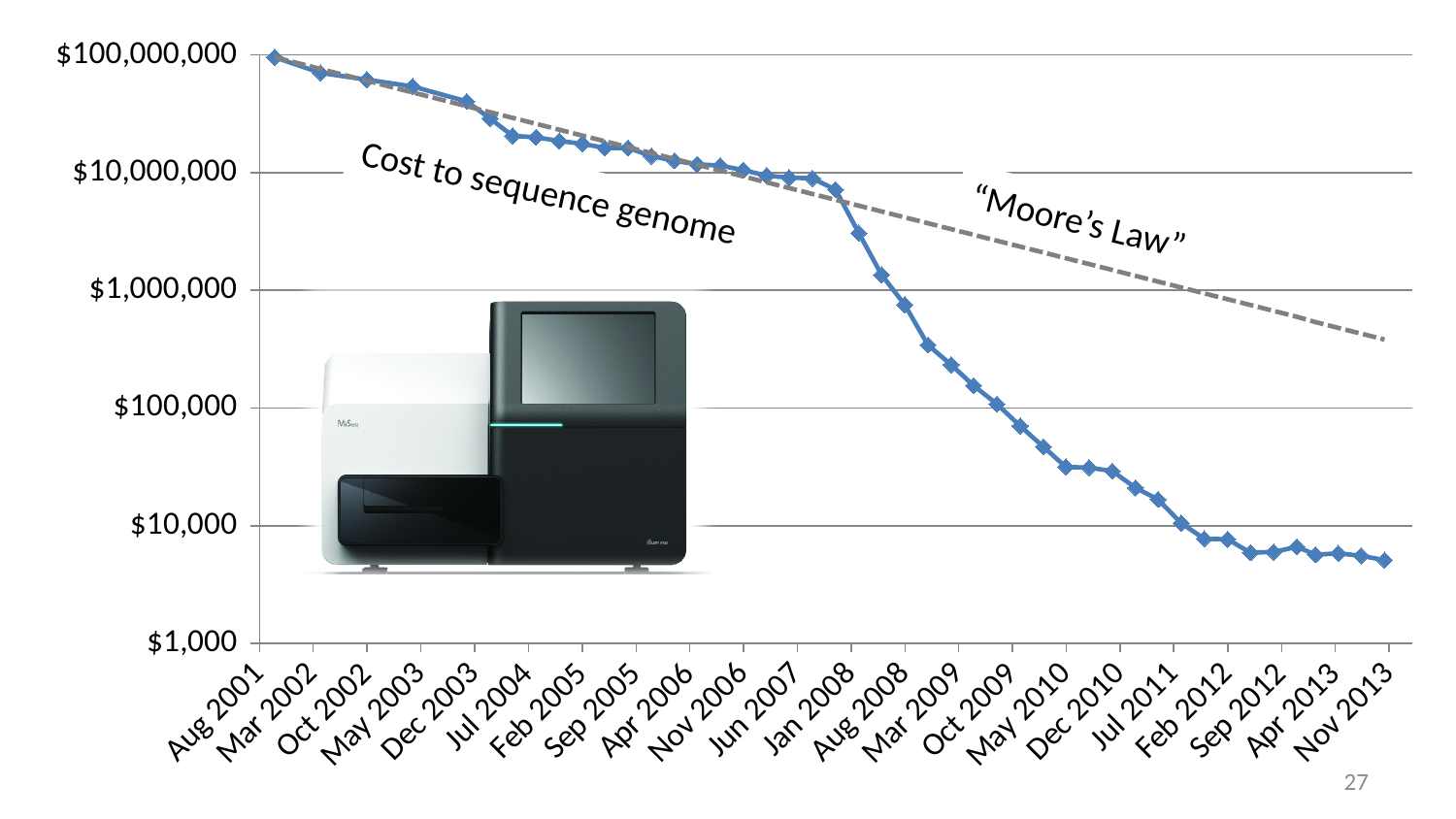
What is the highest value shown on the y axis? $100,000,000 Is the cost to sequence a genome in Mar 2009 greater or less than $1,000,000? less Is the cost to sequence a genome in Nov 2013 greater or less than $10,000? less Does the cost to sequence a genome rise or fall from Aug 2001 to Nov 2013? fall What label is given to the dashed grey line on the chart? "Moore's Law" Is the cost to sequence a genome in Aug 2001 greater or less than $10,000,000? greater Which date on the x axis has the highest cost to sequence a genome? Aug 2001 At Nov 2013, which is higher: the "Moore's Law" dashed line or the cost to sequence genome line? "Moore's Law" dashed line How many date labels are shown on the x axis? 22 Which is larger, the cost to sequence a genome in Jan 2008 or in Aug 2008? Jan 2008 What kind of chart is shown on the slide? line chart